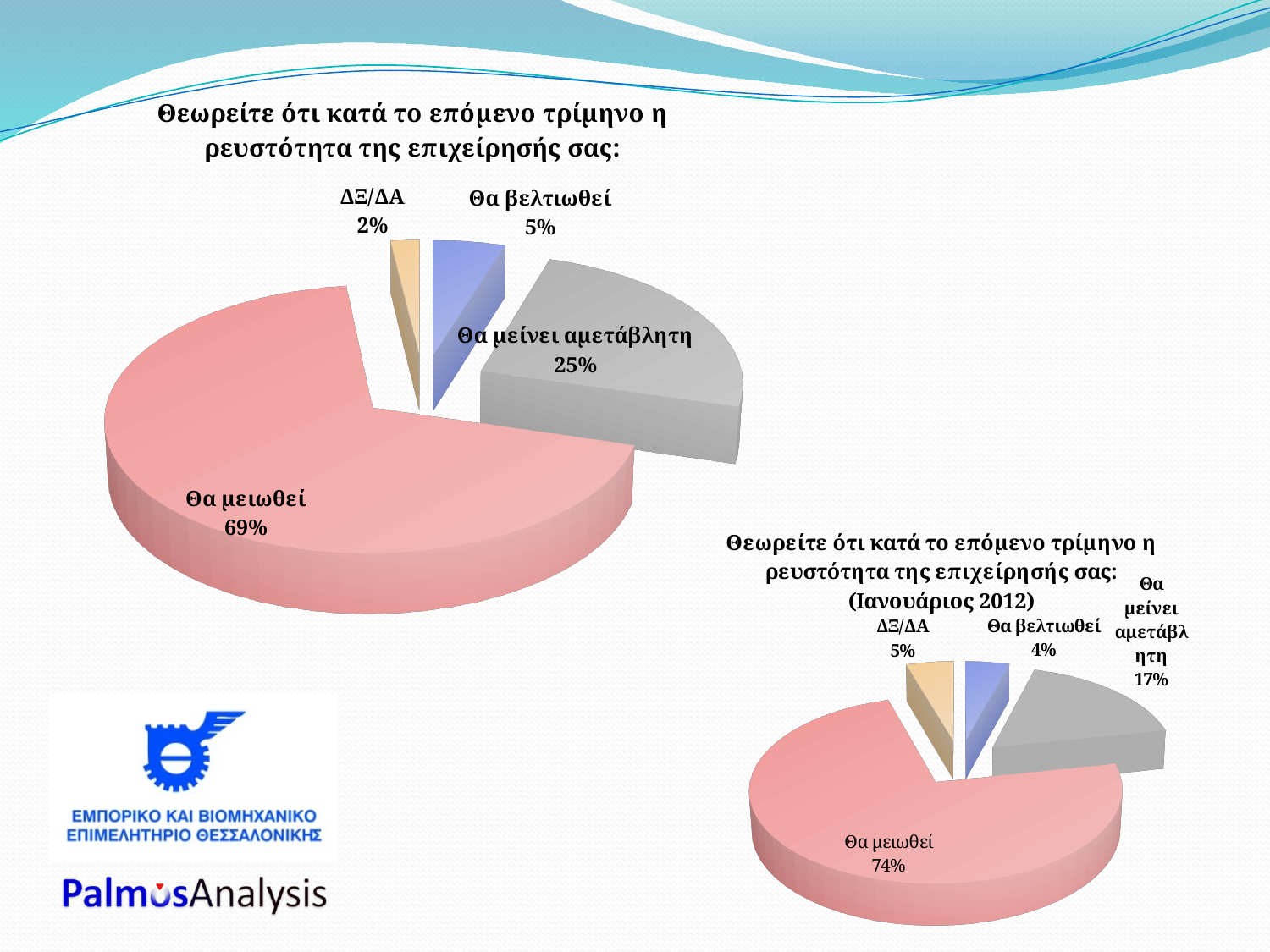
In the large pie chart on the left, what share is labelled for "ΔΞ/ΔΑ"? 2% In the large pie chart on the left, what share is labelled for "Θα μειωθεί"? 69% In the large pie chart on the left, what share is labelled for "Θα μείνει αμετάβλητη"? 25% What kind of chart is the large chart on the left of the slide? Pie chart In the smaller pie chart on the bottom right (Ιανουάριος 2012), what share is labelled for "Θα μείνει αμετάβλητη"? 17% In the smaller pie chart on the bottom right (Ιανουάριος 2012), which is larger, the share for "ΔΞ/ΔΑ" or the share for "Θα βελτιωθεί"? ΔΞ/ΔΑ In the large pie chart on the left, what is the difference between the shares for "Θα μειωθεί" and "Θα μείνει αμετάβλητη"? 44% In the smaller pie chart on the bottom right (Ιανουάριος 2012), what share is labelled for "Θα μειωθεί"? 74% In the large pie chart on the left, which category has the smallest slice? ΔΞ/ΔΑ Which period is named in parentheses in the title of the smaller pie chart on the bottom right? Ιανουάριος 2012 In the large pie chart on the left, which category has the largest slice? Θα μειωθεί In the large pie chart on the left, how many slices does the pie have? 4